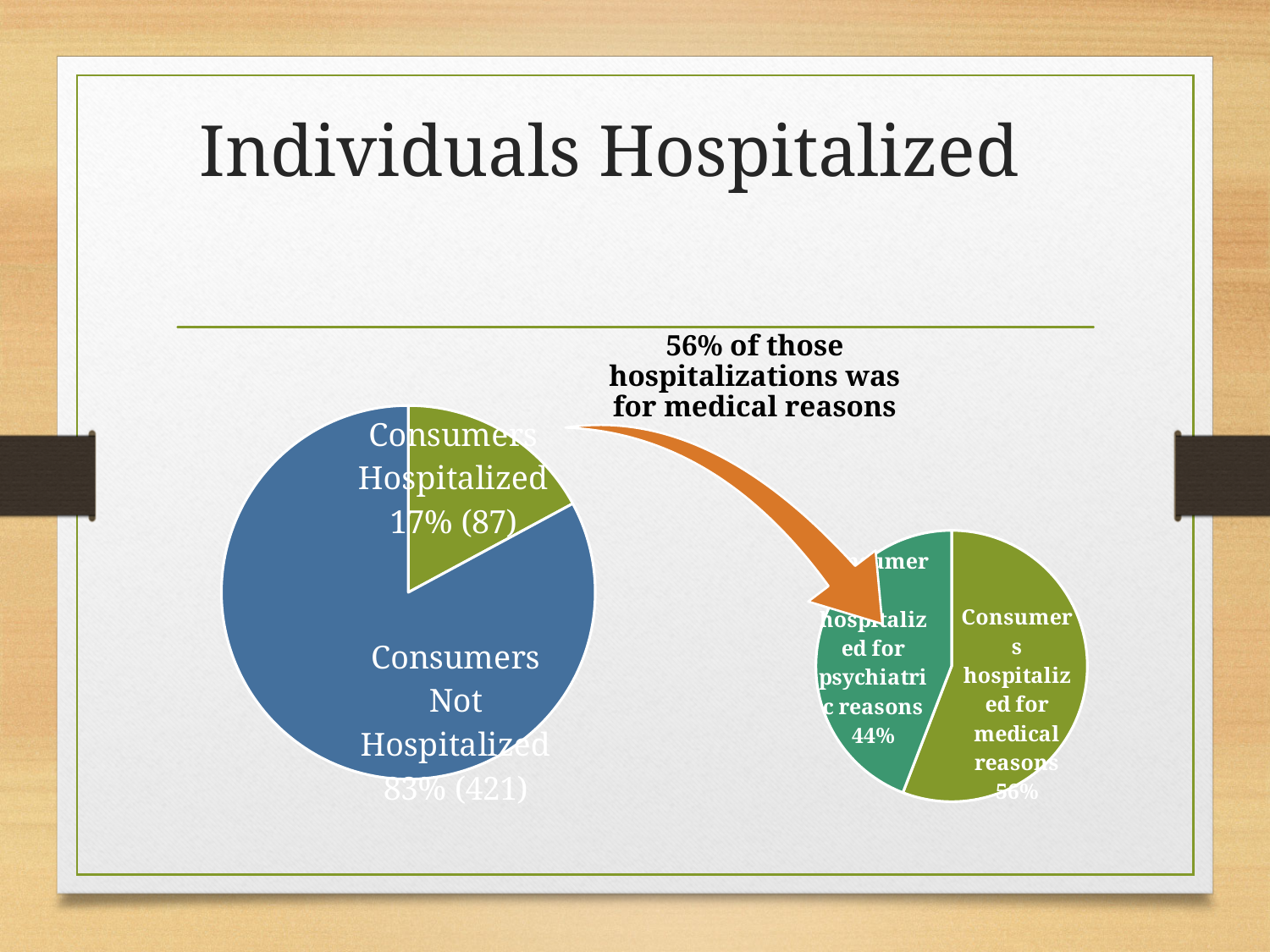
On the right pie chart, what share of hospitalizations was for psychiatric reasons? 44% On the right pie chart, is the share for medical reasons larger or smaller than the share for psychiatric reasons? larger On the left pie chart, which slice is the largest? Consumers Not Hospitalized On the left pie chart, how many consumers were hospitalized? 87 On the left pie chart, what percentage of consumers were not hospitalized? 83% On the left pie chart, what is the difference in count between consumers not hospitalized and consumers hospitalized? 334 What type of chart is used on the left side of the slide? pie chart On the right pie chart, what share of hospitalizations was for medical reasons? 56% On the right pie chart, which slice is smaller? Consumers hospitalized for psychiatric reasons How many slices does the right pie chart have? 2 On the left pie chart, how many consumers were not hospitalized? 421 On the left pie chart, what percentage of consumers were hospitalized? 17%